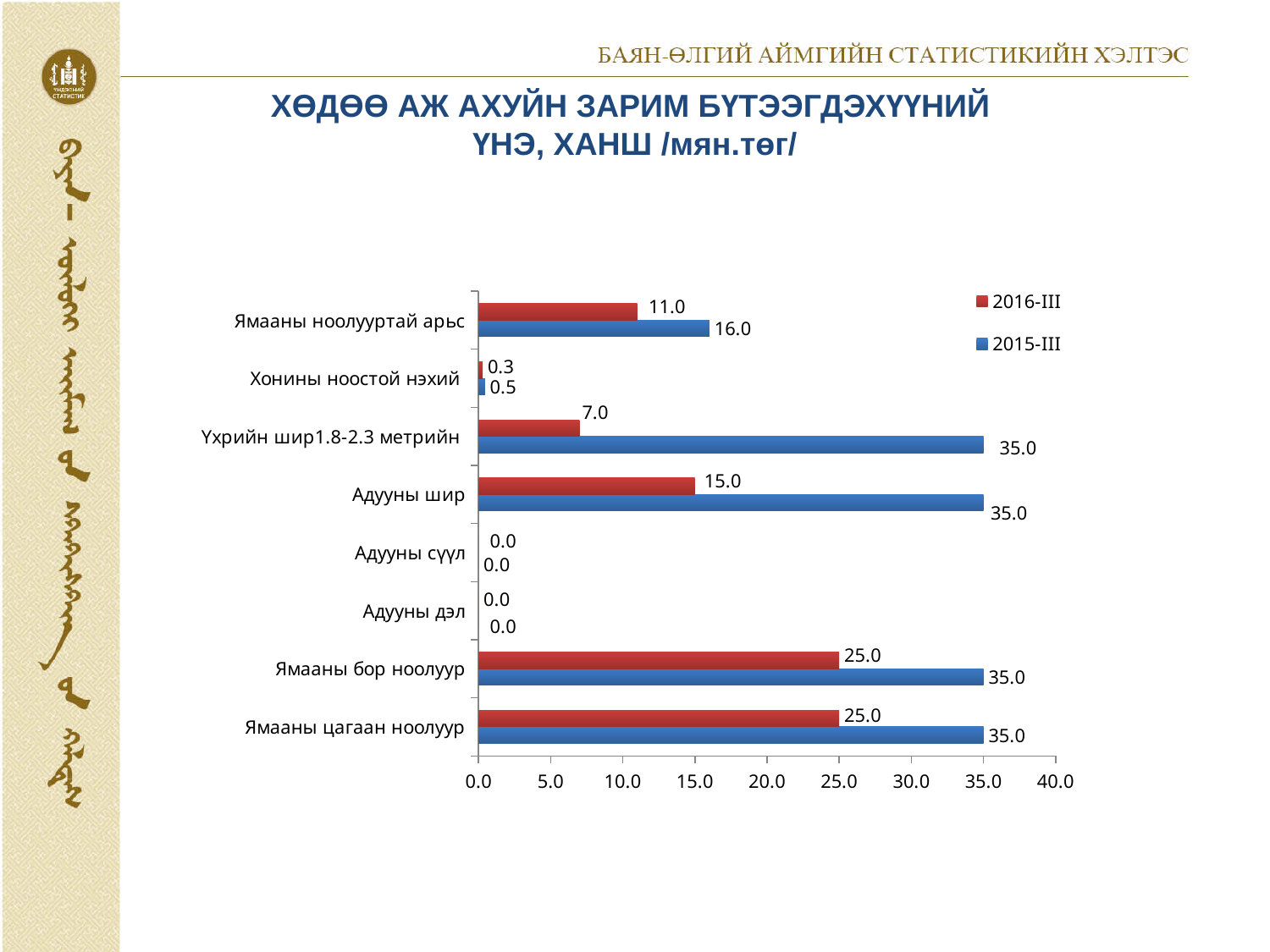
Which category has the highest 2016-III value? Ямааны бор ноолуур and Ямааны цагаан ноолуур (25.0) Which colour represents the 2015-III series? Blue What is the 2015-III value for Хонины ноостой нэхий? 0.5 What is the difference between the 2015-III and 2016-III values for Ямааны ноолууртай арьс? 5.0 What is the 2016-III value for Үхрийн шир1.8-2.3 метрийн? 7.0 How many categories are shown on the chart? 8 What is the 2016-III value for Ямааны ноолууртай арьс? 11.0 How many series does the legend list? 2 What is the difference between the 2015-III and 2016-III values for Үхрийн шир1.8-2.3 метрийн? 28.0 What kind of chart is shown on the slide? Bar chart What is the 2015-III value for Адууны шир? 35.0 Which is larger for Адууны шир: the 2015-III value or the 2016-III value? 2015-III